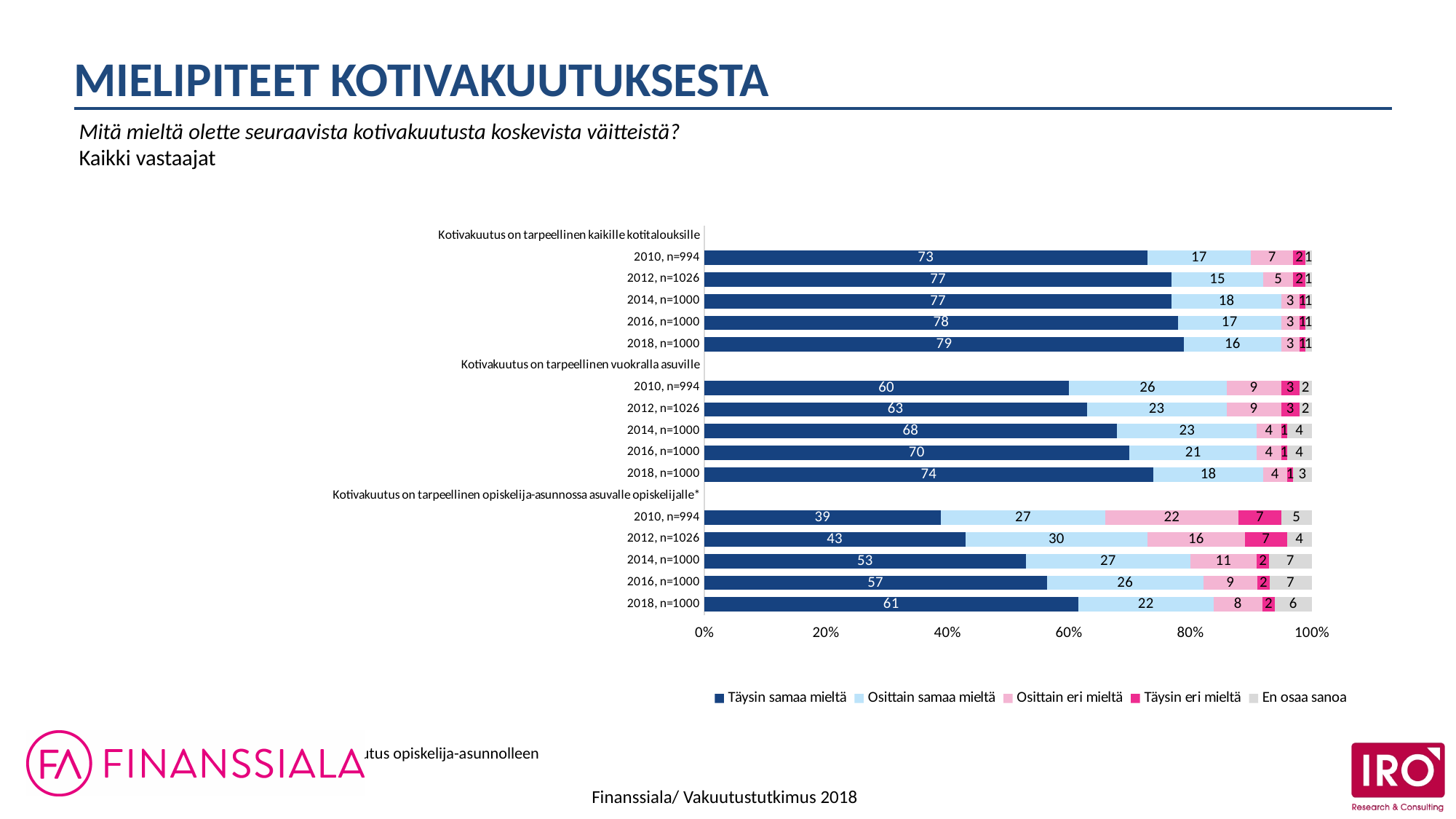
What is the 'Osittain eri mieltä' value for 2010, n=994 under 'Kotivakuutus on tarpeellinen vuokralla asuville'? 9 What is the 'Osittain samaa mieltä' value for 2012, n=1026 under 'Kotivakuutus on tarpeellinen opiskelija-asunnossa asuvalle opiskelijalle*'? 30 How many series does the legend list? 5 How many bars (year rows) are plotted in the chart in total? 15 What is the 'Täysin eri mieltä' value for 2012, n=1026 under 'Kotivakuutus on tarpeellinen opiskelija-asunnossa asuvalle opiskelijalle*'? 7 What is the 'Täysin samaa mieltä' value for 2018, n=1000 under 'Kotivakuutus on tarpeellinen kaikille kotitalouksille'? 79 What kind of chart is shown on the slide? Stacked bar chart Which year has the lowest 'Täysin samaa mieltä' value under 'Kotivakuutus on tarpeellinen opiskelija-asunnossa asuvalle opiskelijalle*'? 2010, n=994 How does the 'Täysin samaa mieltä' value change from 2010 to 2018 under 'Kotivakuutus on tarpeellinen kaikille kotitalouksille'? It rises Which is larger: the 'Osittain samaa mieltä' value for 2010 under 'Kotivakuutus on tarpeellinen vuokralla asuville' or for 2010 under 'Kotivakuutus on tarpeellinen kaikille kotitalouksille'? 2010 under 'Kotivakuutus on tarpeellinen vuokralla asuville' What is the difference between the 'Täysin samaa mieltä' values for 2018 and 2010 under 'Kotivakuutus on tarpeellinen opiskelija-asunnossa asuvalle opiskelijalle*'? 22 Which year has the highest 'Täysin samaa mieltä' value under 'Kotivakuutus on tarpeellinen vuokralla asuville'? 2018, n=1000